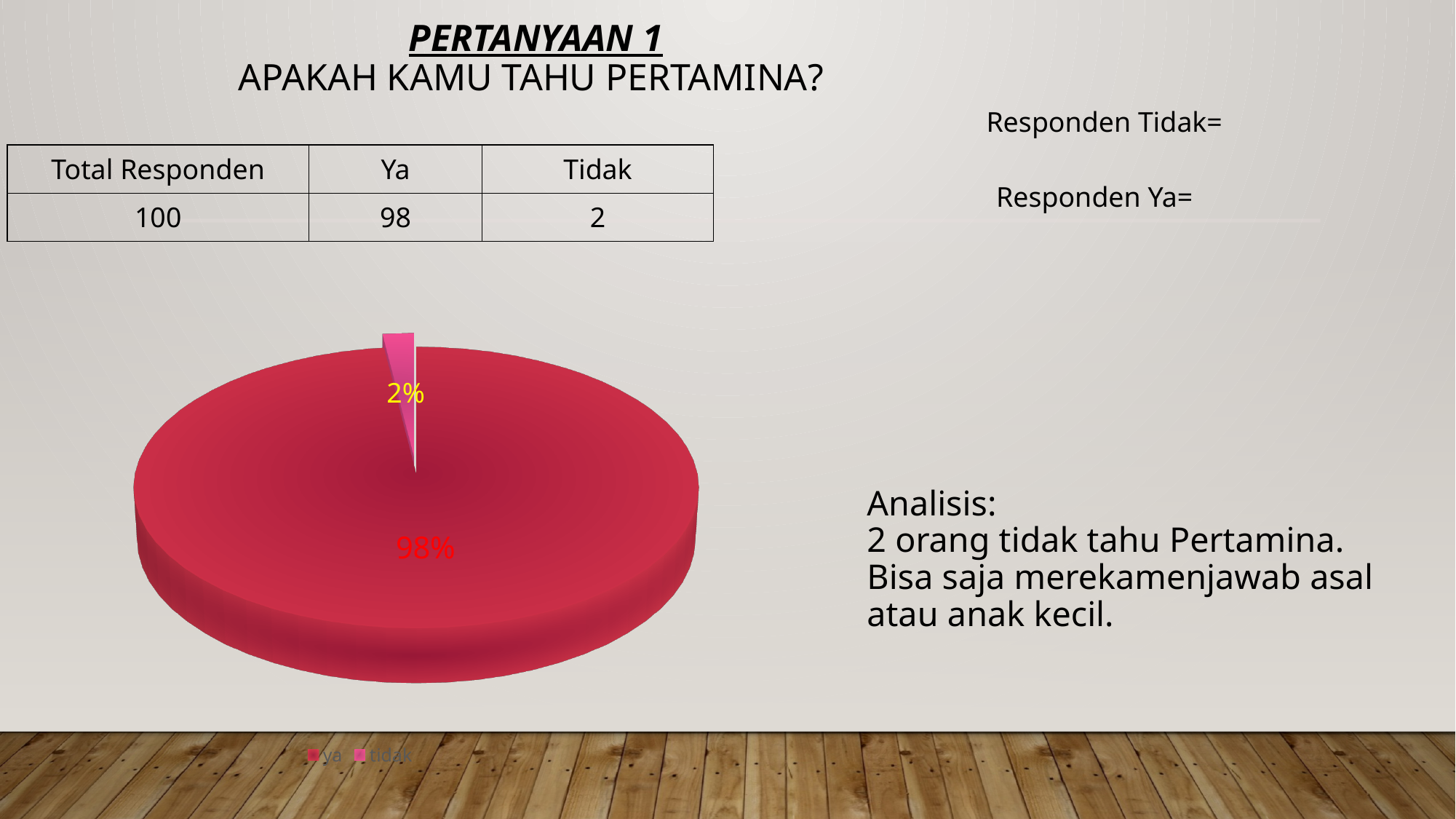
What are the two entries listed in the chart legend? ya, tidak What share of the pie does the 'ya' slice represent? 98% How many slices does the pie chart have? 2 Which slice of the pie is the largest? ya What is the difference in percentage points between the 'ya' slice and the 'tidak' slice? 96 What share of the pie does the 'tidak' slice represent? 2% Which slice of the pie is the smallest? tidak What kind of chart is shown on the slide? pie chart Which is larger, the 'ya' slice or the 'tidak' slice? ya Is the share of the 'ya' slice greater or less than 50%? greater How many entries does the chart legend list? 2 What is the total of the two pie slice percentages shown? 100%